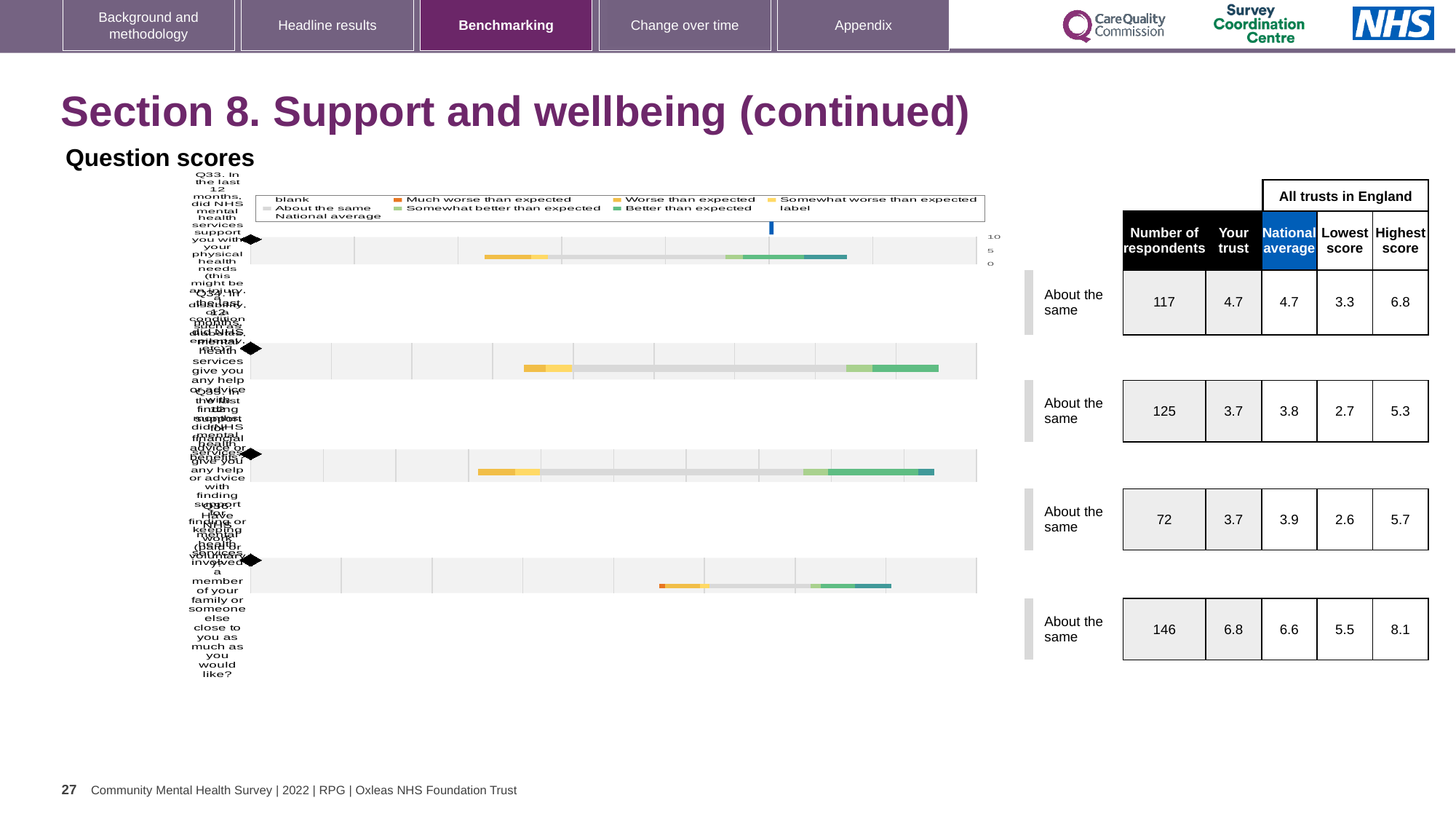
Which question row has the highest 'Your trust' score? the fourth (bottom) row, 6.8 What is the 'Your trust' score for the fourth (bottom) question row? 6.8 What is the national average for the second question row? 3.8 For the fourth question row, which is larger: the 'Your trust' score or the national average? Your trust (6.8) In the chart legend, what colour represents 'Much worse than expected'? orange What kind of chart is used to show the question scores on this slide? bar chart For the third question row, what is the difference between the national average (3.9) and the 'Your trust' score (3.7)? 0.2 What comparison label is shown next to each of the four question rows? About the same For the first question row, what is the difference between the highest score (6.8) and the lowest score (3.3)? 3.5 How many question rows (bars) are plotted in the question scores chart? 4 In the table beside the chart, what is the number of respondents for the first question row (Q33)? 117 Which question row has the lowest number of respondents? the third row, 72